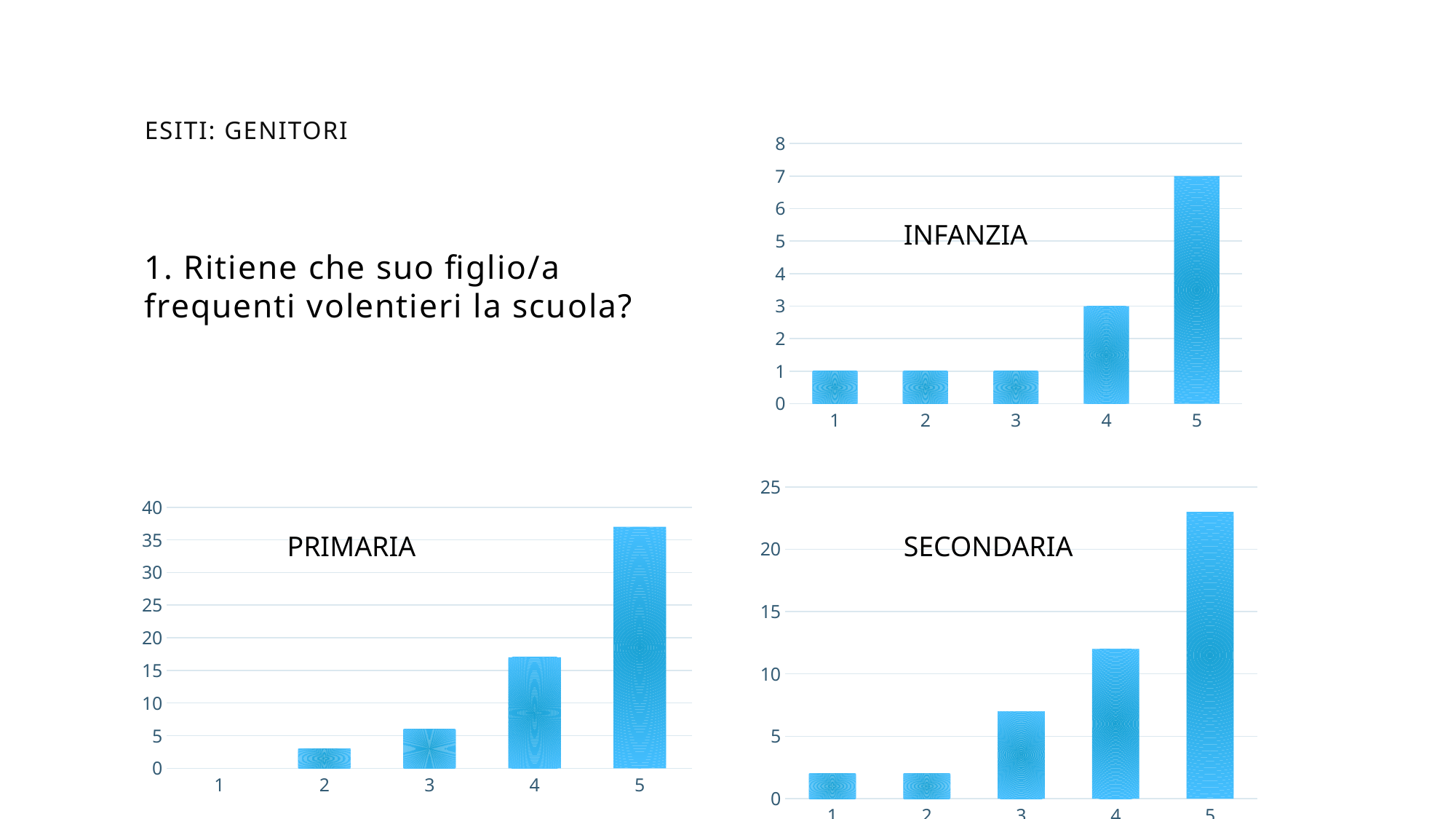
In the PRIMARIA chart, is the value for category 5 greater or less than 35? greater In the INFANZIA chart, which category has the highest value? 5 In the INFANZIA chart, what is the value for category 1? 1 How many categories are shown on the x axis of the SECONDARIA chart? 5 In the INFANZIA chart, what is the difference between the values for category 5 and category 4? 4 In the SECONDARIA chart, which is larger, the value for category 3 or the value for category 4? 4 In the SECONDARIA chart, is the value for category 5 greater or less than 20? greater What type of chart is the PRIMARIA chart? bar chart In the PRIMARIA chart, is the value for category 4 greater or less than 20? less In the INFANZIA chart, what is the value for category 4? 3 In the INFANZIA chart, what is the value for category 5? 7 In the PRIMARIA chart, which category has the highest value? 5